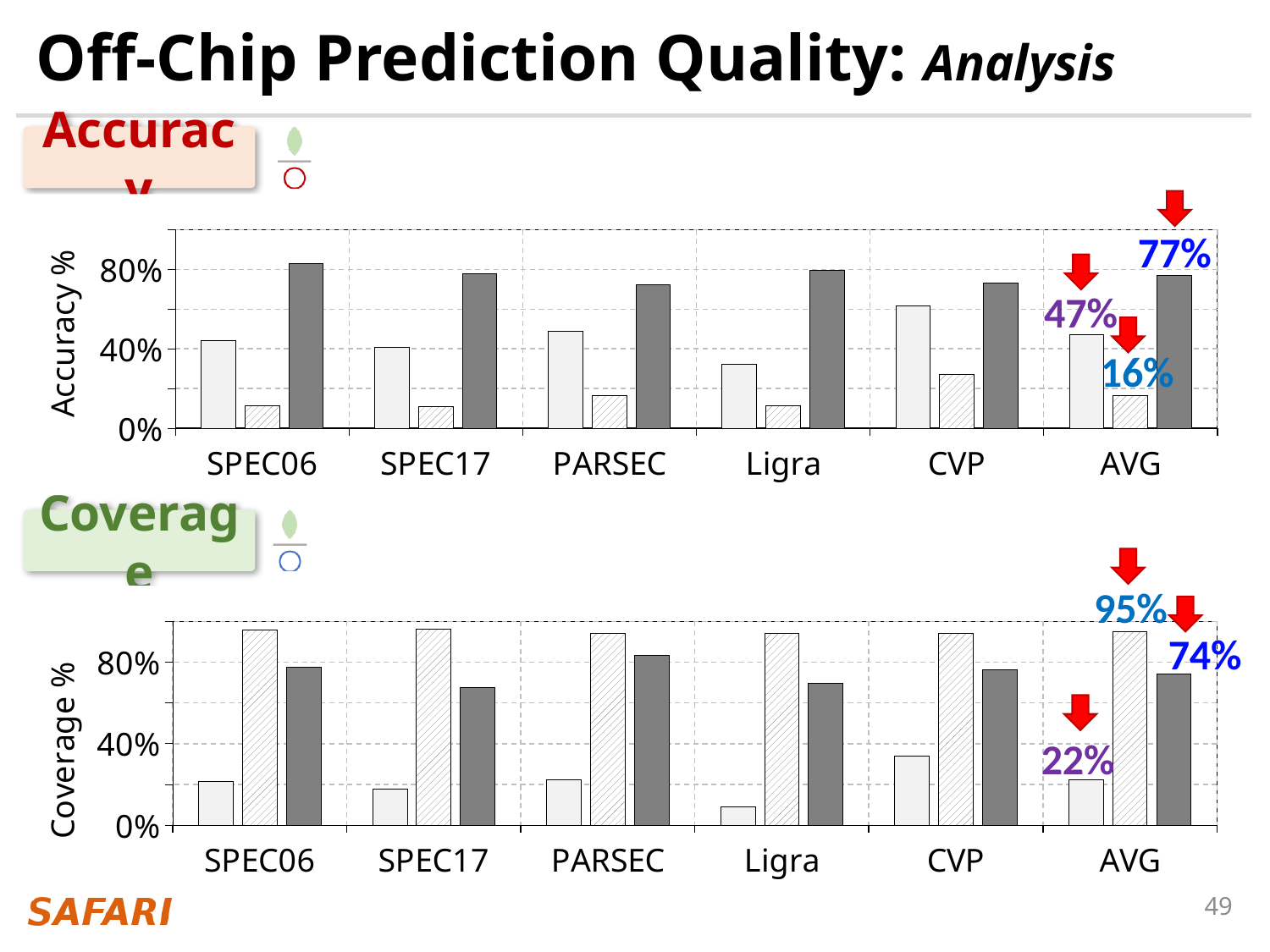
In the Coverage chart, which category has the lowest light gray bar? Ligra How many categories are shown on the x axis of the Accuracy chart? 6 In the Coverage chart, what is the value of the hatched bar for AVG? 95% In the Accuracy chart, is the light gray bar for CVP greater or less than 40%? greater In the Coverage chart, which is larger for AVG: the hatched bar or the dark gray bar? the hatched bar In the Coverage chart, is the light gray bar for Ligra greater or less than 40%? less In the Coverage chart, what is the value of the light gray bar for AVG? 22% In the Accuracy chart, what is the difference between the dark gray bar and the light gray bar for AVG? 30 percentage points In the Accuracy chart, what is the value of the dark gray bar for AVG? 77% What kind of chart is the Coverage chart? bar chart In the Accuracy chart, what is the value of the hatched bar for AVG? 16% In the Coverage chart, what is the difference between the hatched bar and the light gray bar for AVG? 73 percentage points